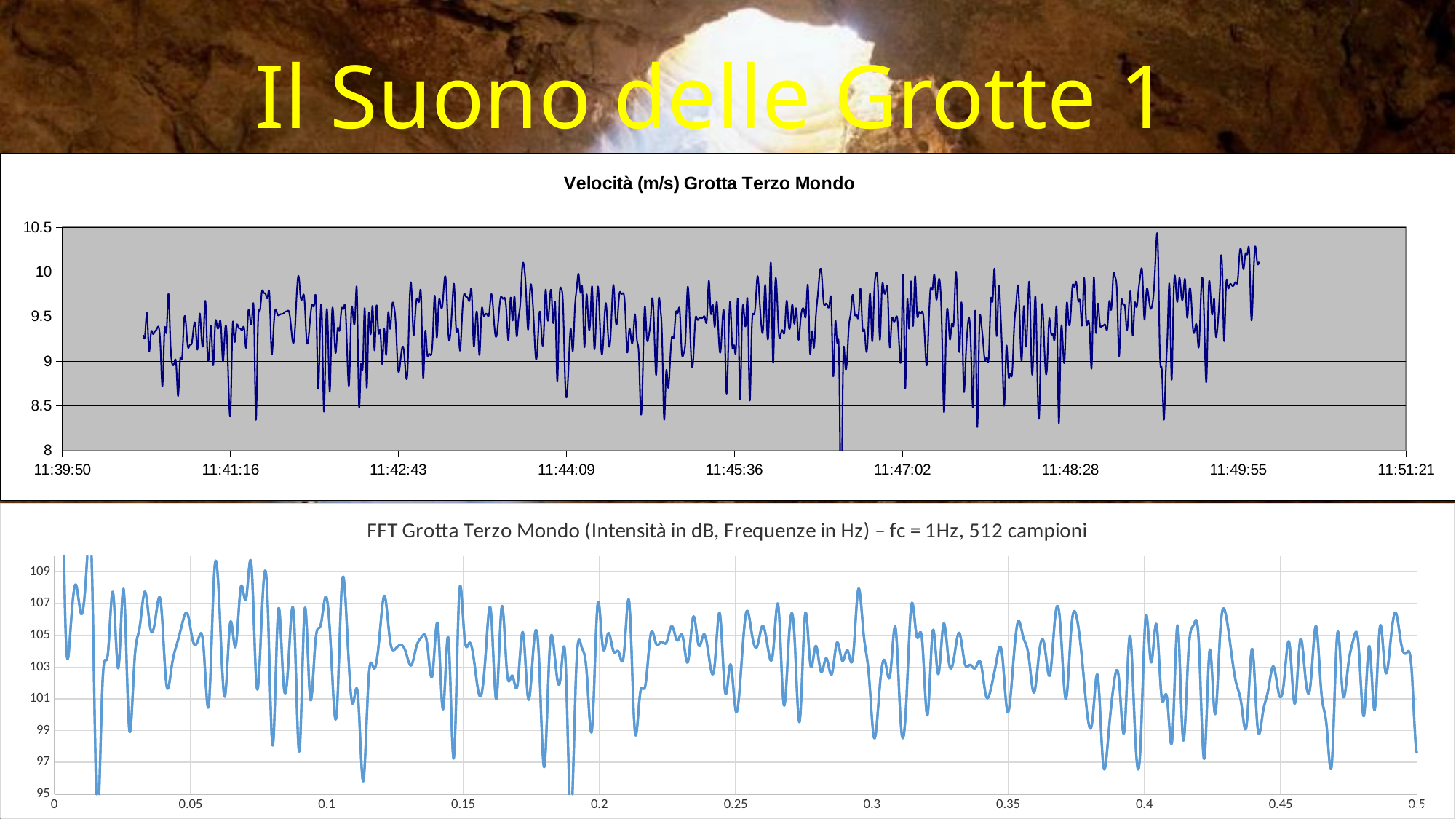
In the bottom FFT chart, is the highest value of the line greater or less than 109? greater What kind of chart is the top chart titled 'Velocità (m/s) Grotta Terzo Mondo'? line chart In the top chart 'Velocità (m/s) Grotta Terzo Mondo', is the lowest value of the line greater or less than 8.5? less In the top chart 'Velocità (m/s) Grotta Terzo Mondo', is the highest value of the line greater or less than 10? greater How many charts are shown on the slide? 2 What is the title of the top chart? Velocità (m/s) Grotta Terzo Mondo In the bottom FFT chart, what sampling frequency and number of samples are stated in the title? fc = 1Hz, 512 campioni What kind of chart is the bottom chart titled 'FFT Grotta Terzo Mondo'? line chart